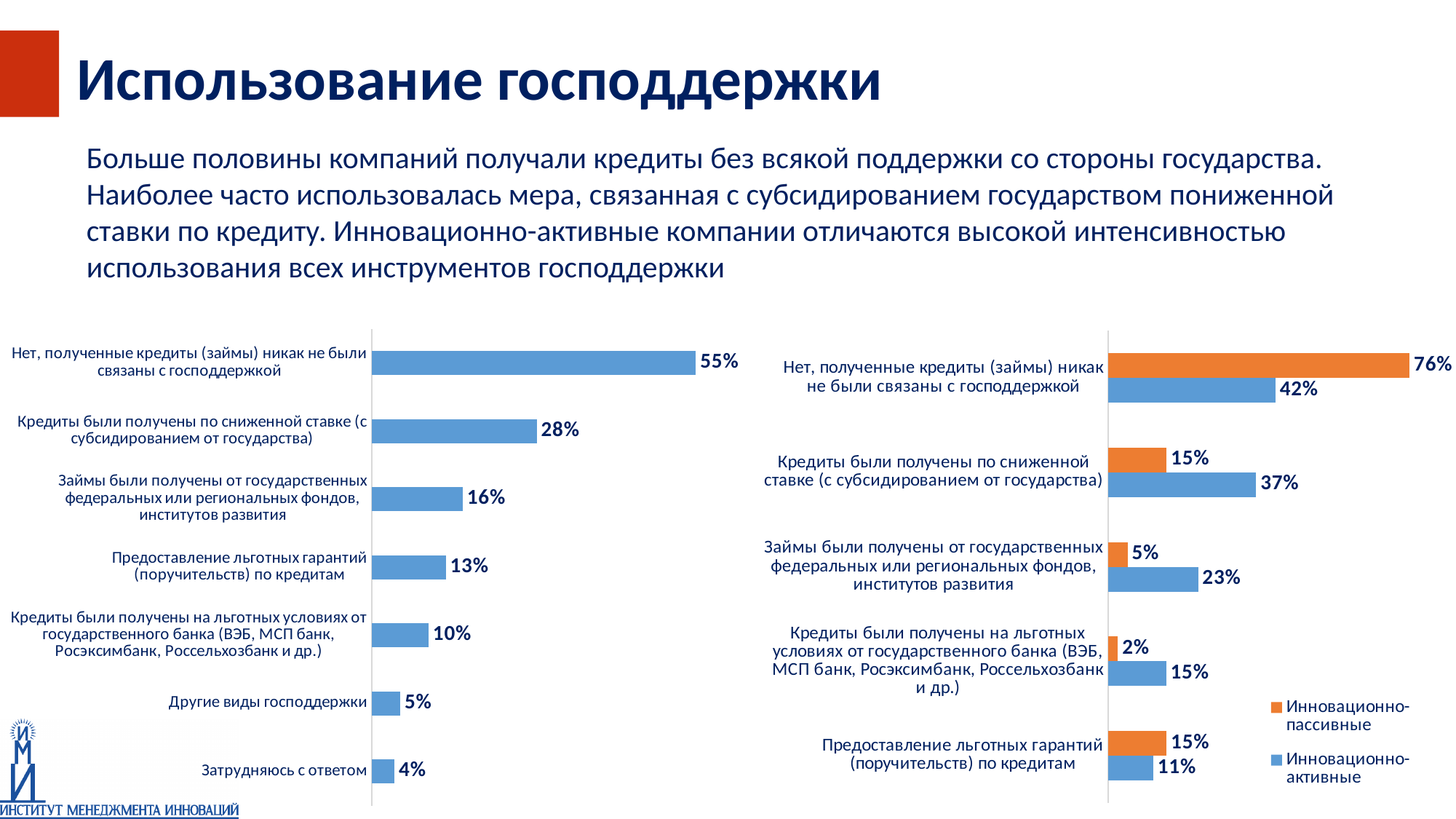
In the right chart, what is the value for "Инновационно-пассивные" for "Нет, полученные кредиты (займы) никак не были связаны с господдержкой"? 76% In the right chart, which series has the larger value for "Займы были получены от государственных федеральных или региональных фондов, институтов развития"? Инновационно-активные In the left chart, what is the value for "Нет, полученные кредиты (займы) никак не были связаны с господдержкой"? 55% In the right chart, what is the difference between "Инновационно-пассивные" and "Инновационно-активные" for "Нет, полученные кредиты (займы) никак не были связаны с господдержкой"? 34% In the left chart, what is the difference between "Кредиты были получены по сниженной ставке (с субсидированием от государства)" and "Займы были получены от государственных федеральных или региональных фондов, институтов развития"? 12% In the right chart, which colour represents the "Инновационно-пассивные" series? Orange In the left chart, what is the value for "Предоставление льготных гарантий (поручительств) по кредитам"? 13% In the right chart, what is the value for "Инновационно-активные" for "Кредиты были получены по сниженной ставке (с субсидированием от государства)"? 37% In the left chart, which category has the lowest value? Затрудняюсь с ответом What type of chart is the right chart? Bar chart In the right chart, how many series does the legend list? 2 In the left chart, how many categories are shown? 7